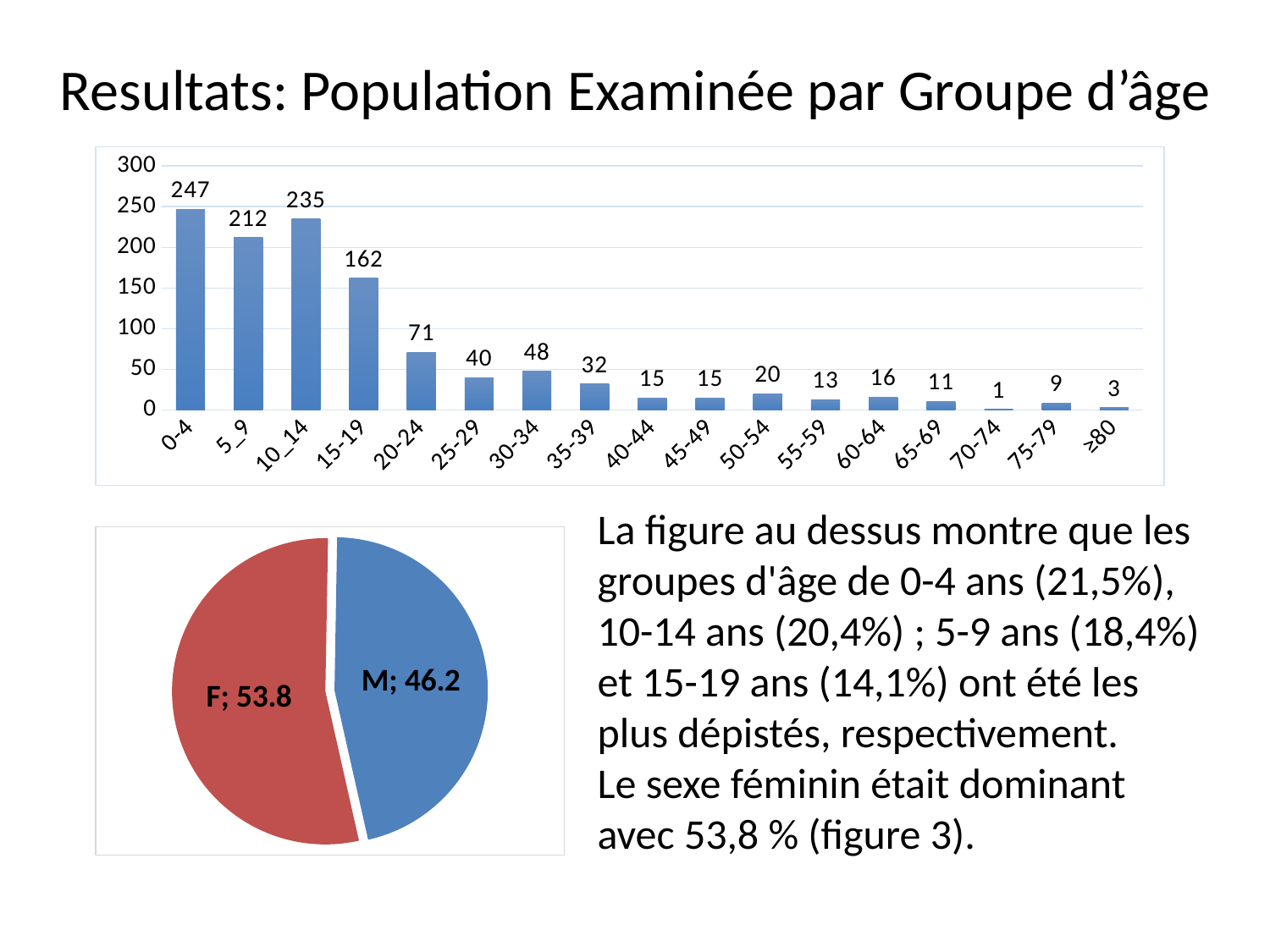
In the bar chart at the top of the slide, which age group has the highest value? 0-4 In the bar chart at the top of the slide, what is the value for the 0-4 age group? 247 In the pie chart at the bottom left of the slide, which slice is larger, F or M? F In the pie chart at the bottom left of the slide, what is the value shown for F? 53.8 In the bar chart at the top of the slide, what is the value for the ≥80 age group? 3 In the bar chart at the top of the slide, which age group has the lowest value? 70-74 What kind of chart is the chart at the top of the slide? bar chart In the bar chart at the top of the slide, how many age groups are shown on the x axis? 17 In the bar chart at the top of the slide, which is larger, the value for 20-24 or the value for 30-34? 20-24 In the bar chart at the top of the slide, what is the difference between the values for 0-4 and 10_14? 12 In the bar chart at the top of the slide, what is the value for the 15-19 age group? 162 What kind of chart is the chart at the bottom left of the slide? pie chart